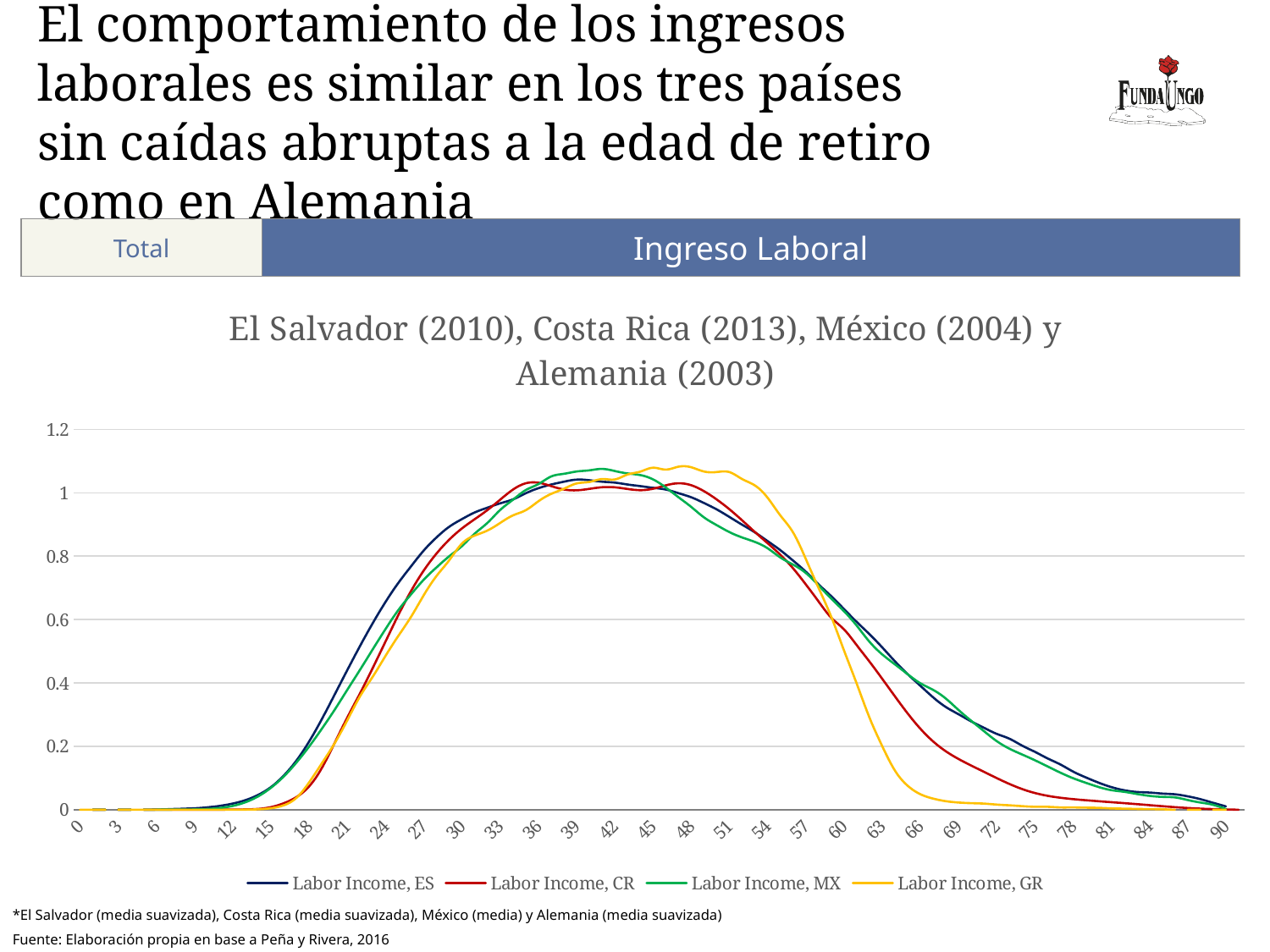
How many series does the legend list? 4 Which series has the lowest value at age 69? Labor Income, GR Is the value for Labor Income, ES at age 21 greater or less than 0.4? greater Is the value for Labor Income, GR at age 66 greater or less than 0.2? less At age 21, which is larger: Labor Income, ES or Labor Income, GR? Labor Income, ES What kind of chart is shown on the slide? Line chart Do the values for Labor Income, ES rise or fall between age 60 and age 90? Fall Is the value for Labor Income, GR at age 51 greater or less than 1? greater What is the title of the chart? El Salvador (2010), Costa Rica (2013), México (2004) y Alemania (2003) Which series is drawn in yellow? Labor Income, GR At age 63, which is larger: Labor Income, ES or Labor Income, GR? Labor Income, ES